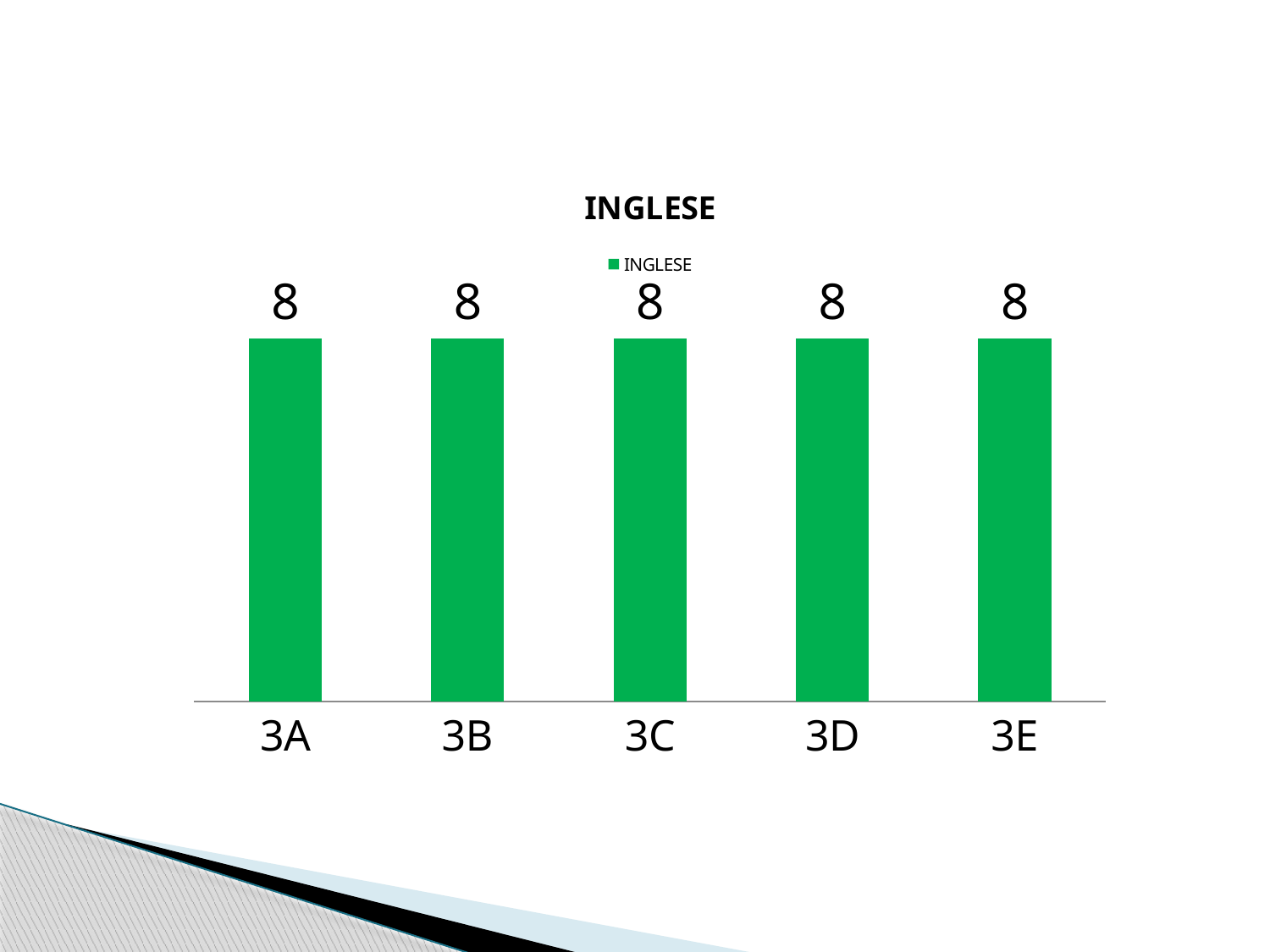
How many series does the legend list? 1 Do the values rise, fall or stay the same from 3A to 3E? stay the same What is the title of the chart? INGLESE What kind of chart is shown? bar chart Is the value for 3D greater than 5? greater What is the difference between the values for 3B and 3D? 0 What is the value for 3E? 8 What colour are the bars? green What is the value for 3A? 8 How many categories are shown on the x axis? 5 What is the value for 3C? 8